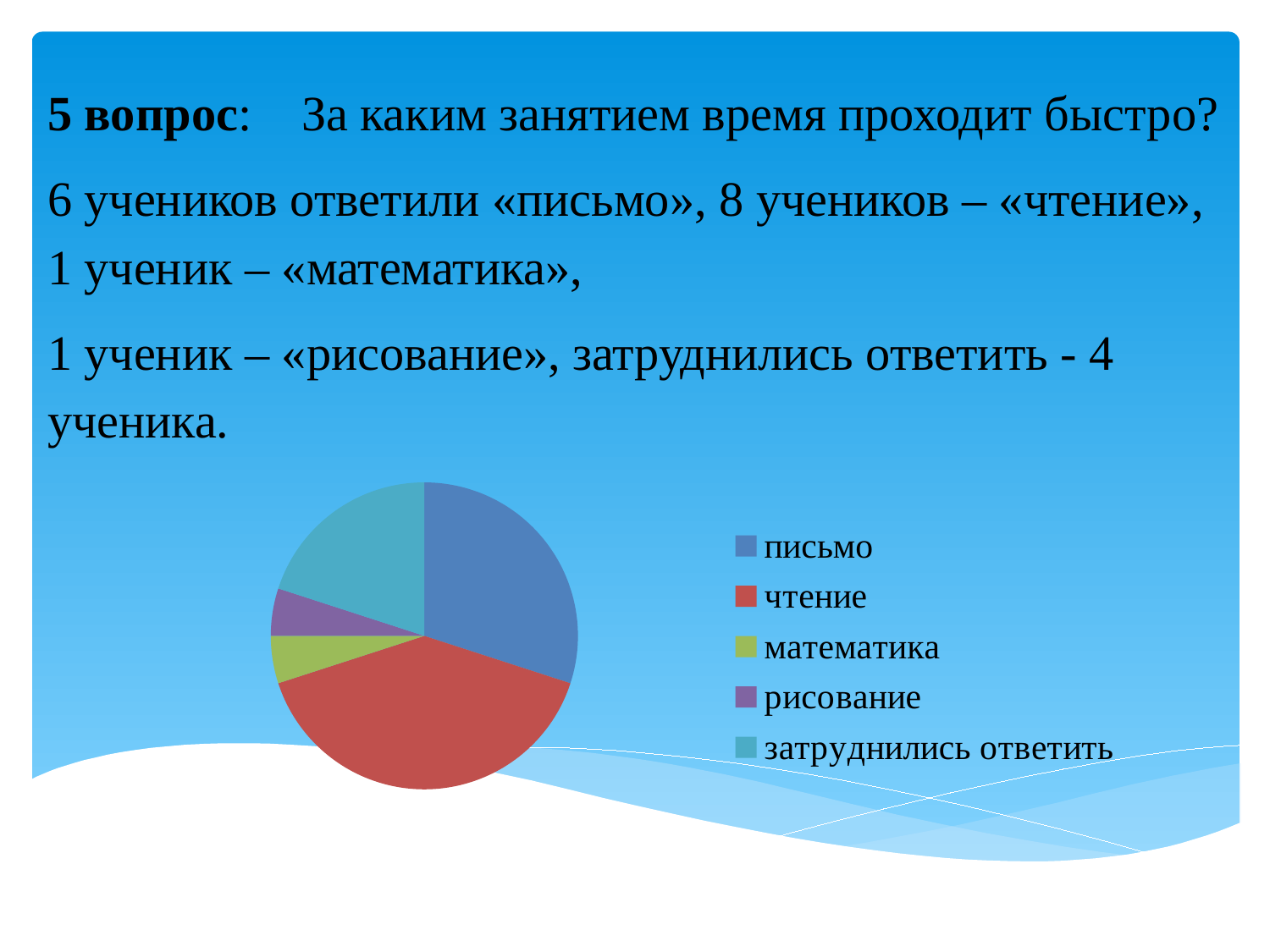
What colour is the «чтение» slice in the pie chart? red According to the slide, how many students answered «чтение»? 8 What kind of chart is shown on the slide? pie chart What is the difference between the number of students who answered «чтение» and those who answered «письмо»? 2 Which slice is larger: чтение or письмо? чтение How many categories does the pie chart's legend list? 5 What share of the pie does the «чтение» slice represent? 40% According to the slide, how many students answered «письмо»? 6 According to the slide, how many students затруднились ответить? 4 Which category has the largest slice of the pie chart? чтение Which slice is larger: письмо or затруднились ответить? письмо What is the total number of students represented in the pie chart? 20